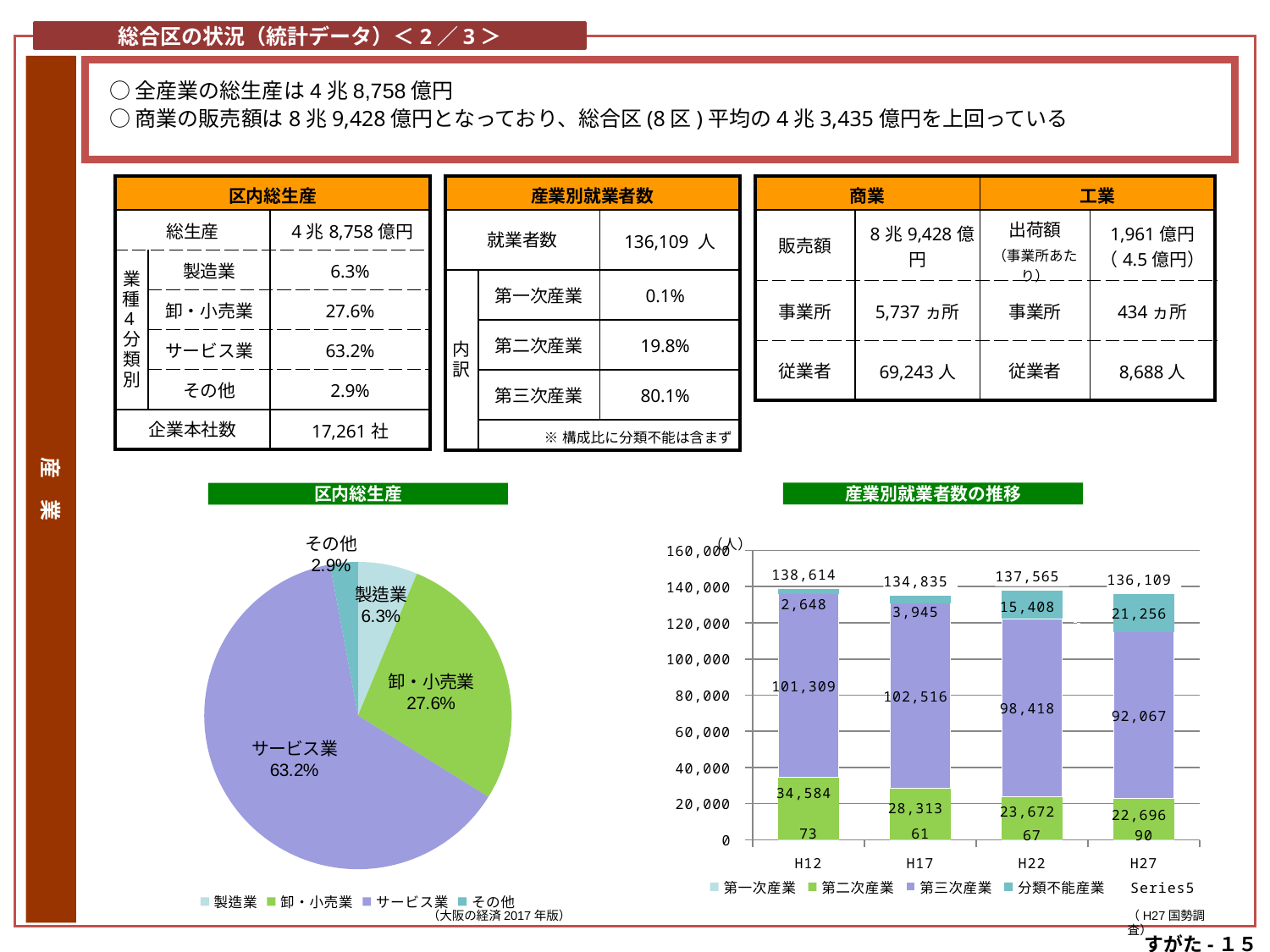
In the chart titled 産業別就業者数の推移, what is the value of 分類不能産業 for H22? 15,408 In the chart titled 産業別就業者数の推移, how many series does the legend list? 5 In the pie chart titled 区内総生産, what is the share for サービス業? 63.2% In the pie chart titled 区内総生産, what is the difference between the shares of 卸・小売業 and 製造業? 21.3% In the chart titled 産業別就業者数の推移, what is the value of 第三次産業 for H17? 102,516 In the chart titled 産業別就業者数の推移, which year has the highest total? H12 What kind of chart is the chart titled 産業別就業者数の推移? stacked bar chart In the pie chart titled 区内総生産, which category has the largest share? サービス業 In the chart titled 産業別就業者数の推移, does the value of 第二次産業 rise or fall from H12 to H27? fall In the chart titled 産業別就業者数の推移, what is the total for H27? 136,109 In the pie chart titled 区内総生産, which category has the smallest share? その他 In the pie chart titled 区内総生産, how many categories are shown? 4